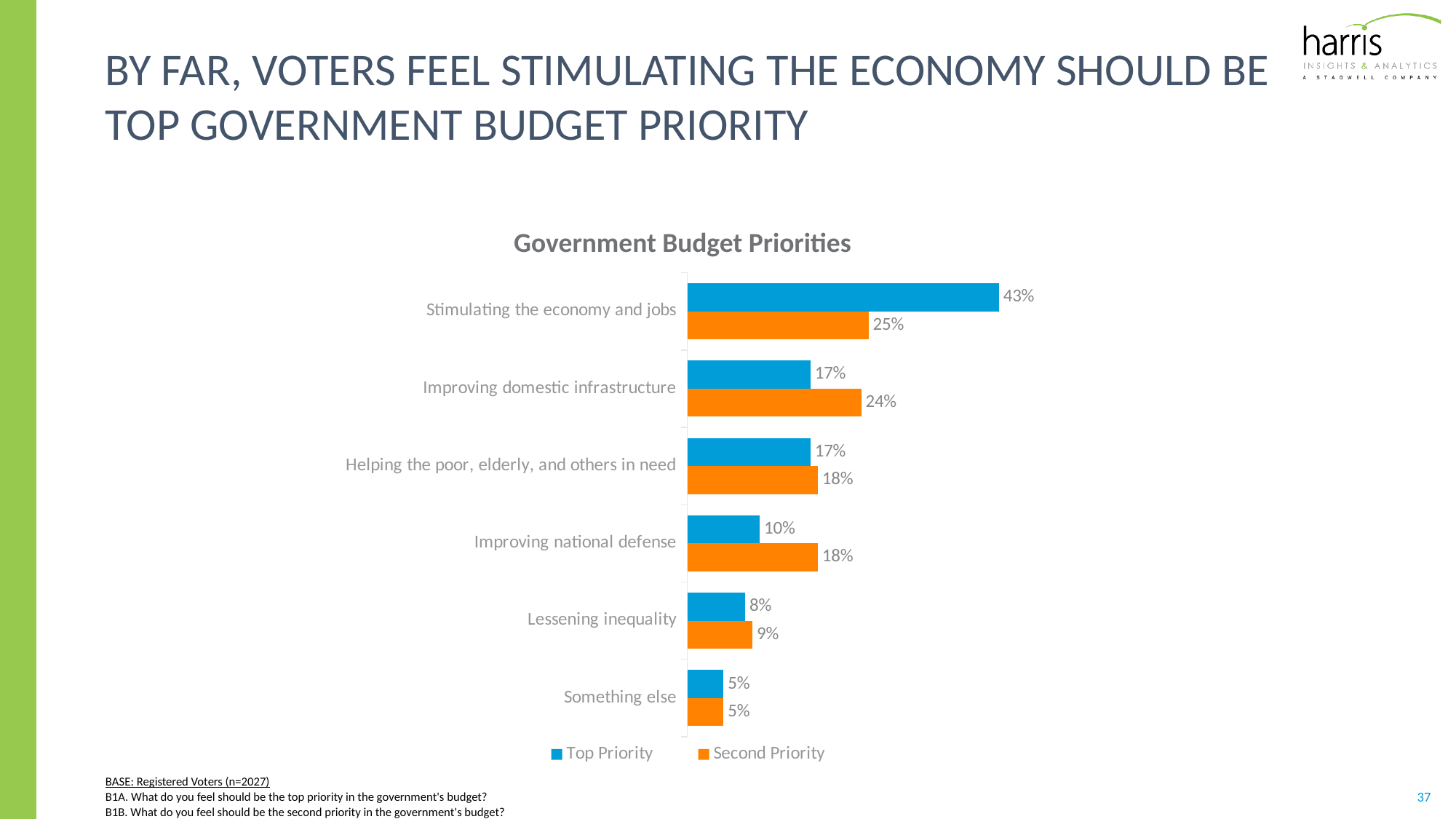
Which category has the lowest Second Priority value? Something else What is the Top Priority value for Stimulating the economy and jobs? 43% What is the Second Priority value for Improving domestic infrastructure? 24% What is the difference between the Top Priority and Second Priority values for Stimulating the economy and jobs? 18% Which colour represents the Second Priority series? Orange What is the title of the chart? Government Budget Priorities How many categories are shown in the chart? 6 What kind of chart is shown on the slide? Bar chart How many series does the legend list? 2 What is the Top Priority value for Improving national defense? 10% Which category has the highest Top Priority value? Stimulating the economy and jobs Which is larger for Improving domestic infrastructure: the Top Priority value or the Second Priority value? Second Priority